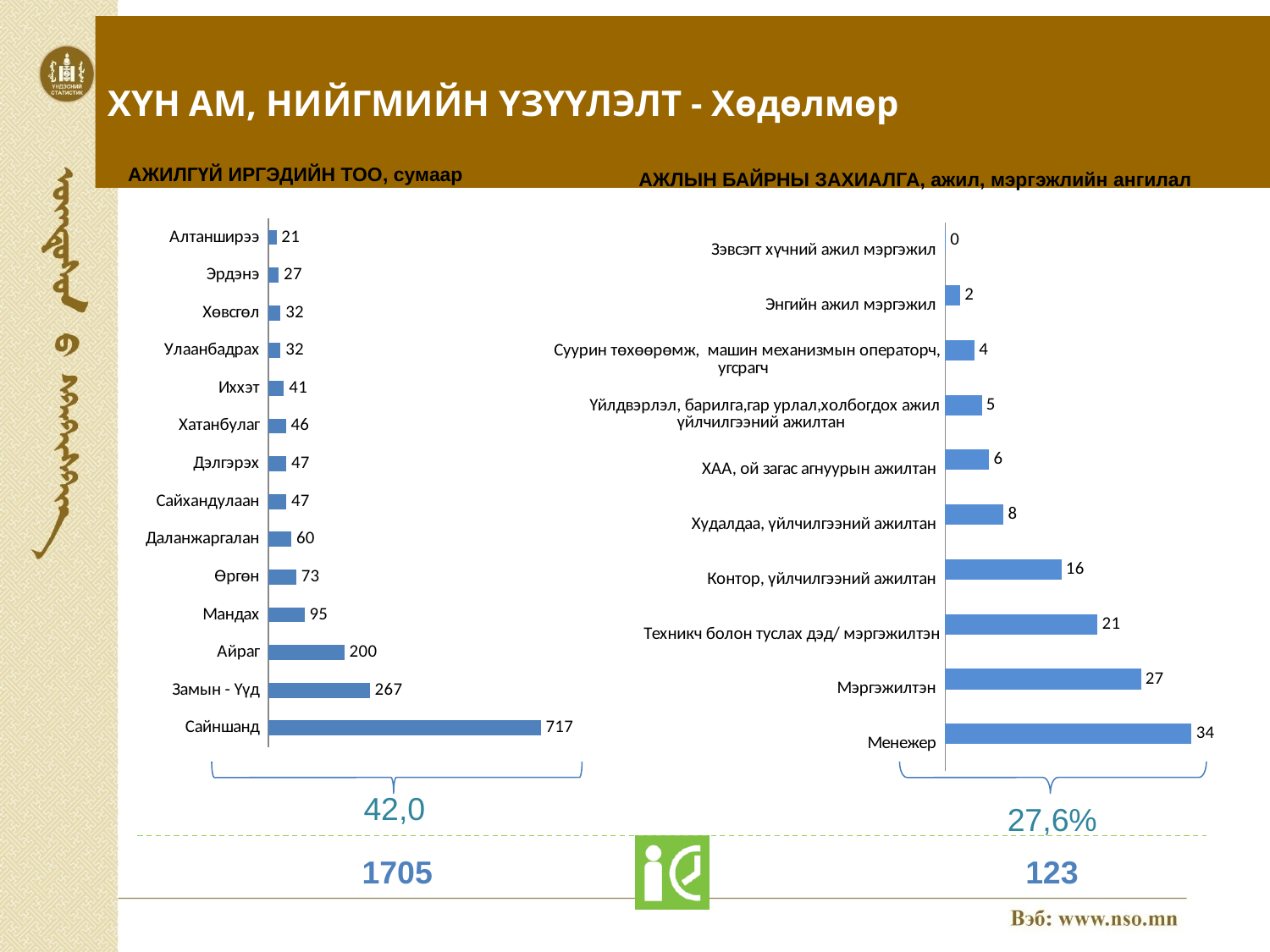
In the left chart (АЖИЛГҮЙ ИРГЭДИЙН ТОО, сумаар), which category has the lowest value? Алтанширээ In the left chart (АЖИЛГҮЙ ИРГЭДИЙН ТОО, сумаар), what is the value for Мандах? 95 In the right chart (АЖЛЫН БАЙРНЫ ЗАХИАЛГА), what is the value for Менежер? 34 In the left chart (АЖИЛГҮЙ ИРГЭДИЙН ТОО, сумаар), what is the value for Сайншанд? 717 In the left chart (АЖИЛГҮЙ ИРГЭДИЙН ТОО, сумаар), what is the difference between Замын - Үүд and Айраг? 67 In the right chart (АЖЛЫН БАЙРНЫ ЗАХИАЛГА), what is the difference between Мэргэжилтэн and Техникч болон туслах дэд/ мэргэжилтэн? 6 In the right chart (АЖЛЫН БАЙРНЫ ЗАХИАЛГА), what is the value for Контор, үйлчилгээний ажилтан? 16 In the left chart (АЖИЛГҮЙ ИРГЭДИЙН ТОО, сумаар), which is larger, Өргөн or Даланжаргалан? Өргөн What type of chart is the left chart (АЖИЛГҮЙ ИРГЭДИЙН ТОО, сумаар)? Bar chart In the right chart (АЖЛЫН БАЙРНЫ ЗАХИАЛГА), which category has the highest value? Менежер In the left chart (АЖИЛГҮЙ ИРГЭДИЙН ТОО, сумаар), how many categories are shown? 14 In the right chart (АЖЛЫН БАЙРНЫ ЗАХИАЛГА), how many categories are shown? 10